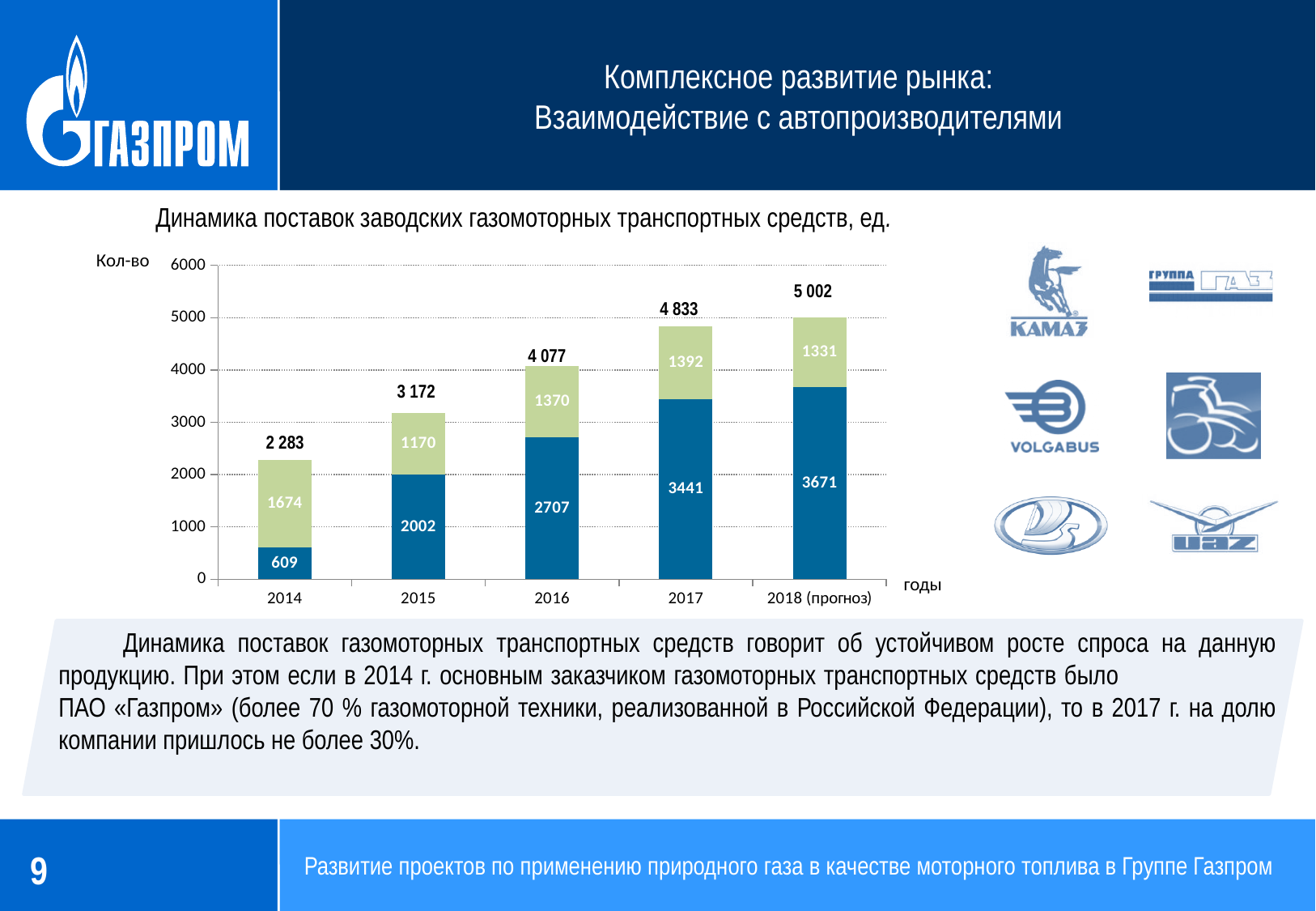
What is the value of the light green (top) segment for 2014? 1674 Which is larger: the light green segment for 2015 or the light green segment for 2016? 2016 Do the total values rise or fall from 2014 to 2018 (прогноз)? Rise What is the total value printed above the bar for 2016? 4 077 What is the value of the dark blue (bottom) segment for 2017? 3441 Which year has the highest total bar? 2018 (прогноз) What is the difference between the total for 2017 and the total for 2016? 756 What kind of chart is shown on the slide? Stacked bar chart What is the value of the dark blue (bottom) segment for 2018 (прогноз)? 3671 How many years (categories) are shown on the x axis? 5 What is the title of the chart? Динамика поставок заводских газомоторных транспортных средств, ед. Which year has the lowest total bar? 2014